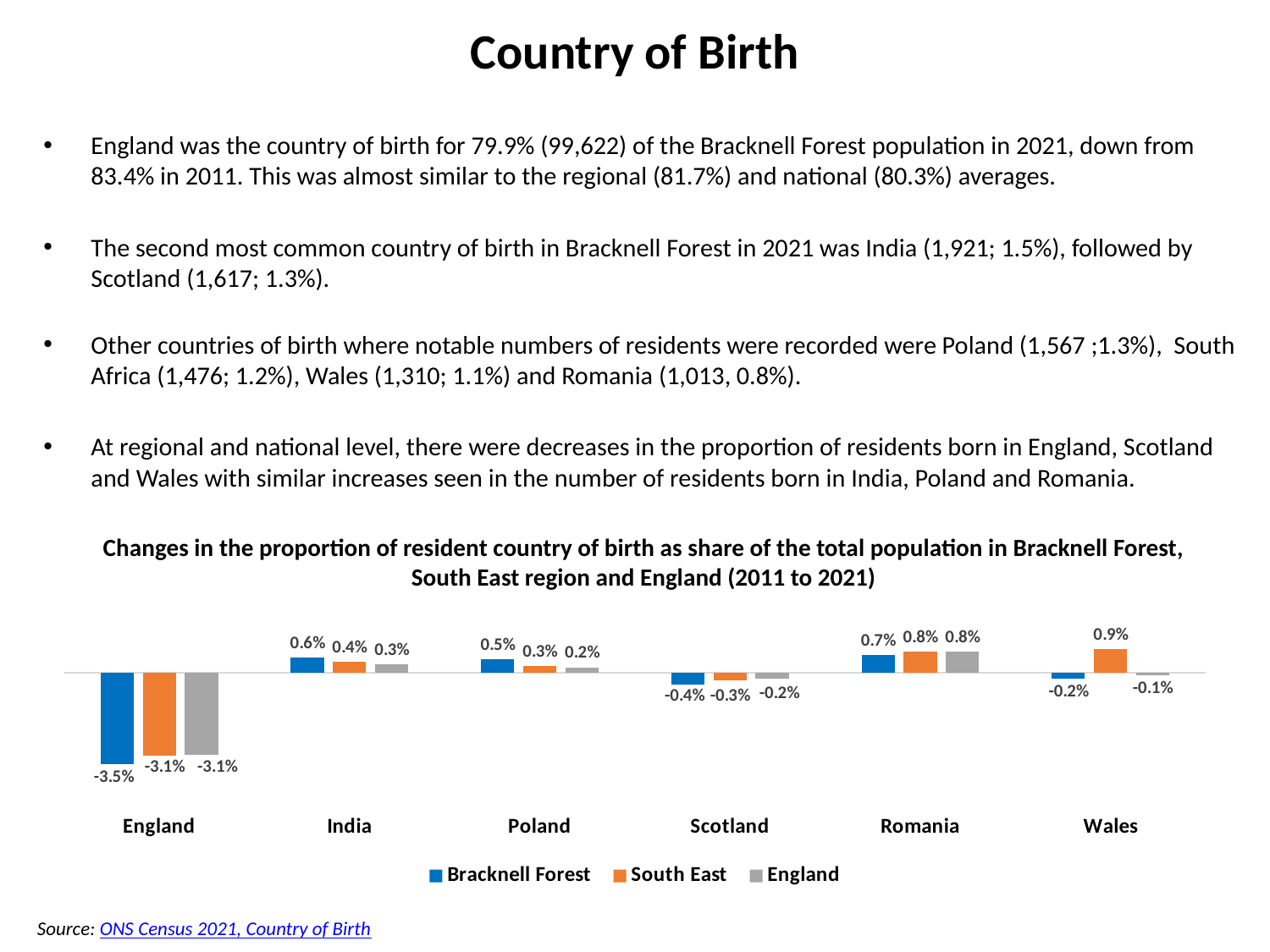
How many series does the legend list? 3 How many countries of birth are shown on the x axis? 6 What is the value for England (series) in the Romania category? 0.8% Which category has the highest value for the Bracknell Forest series? Romania What is the value for Bracknell Forest in the England category? -3.5% What is the difference between the Bracknell Forest and South East values in the India category? 0.2% What is the value for South East in the Wales category? 0.9% What kind of chart is shown on the slide? Bar chart What is the value for Bracknell Forest in the Scotland category? -0.4% In the Poland category, which is larger: the Bracknell Forest value or the England value? Bracknell Forest Which category has the lowest value for the Bracknell Forest series? England Which series is shown in orange in the legend? South East